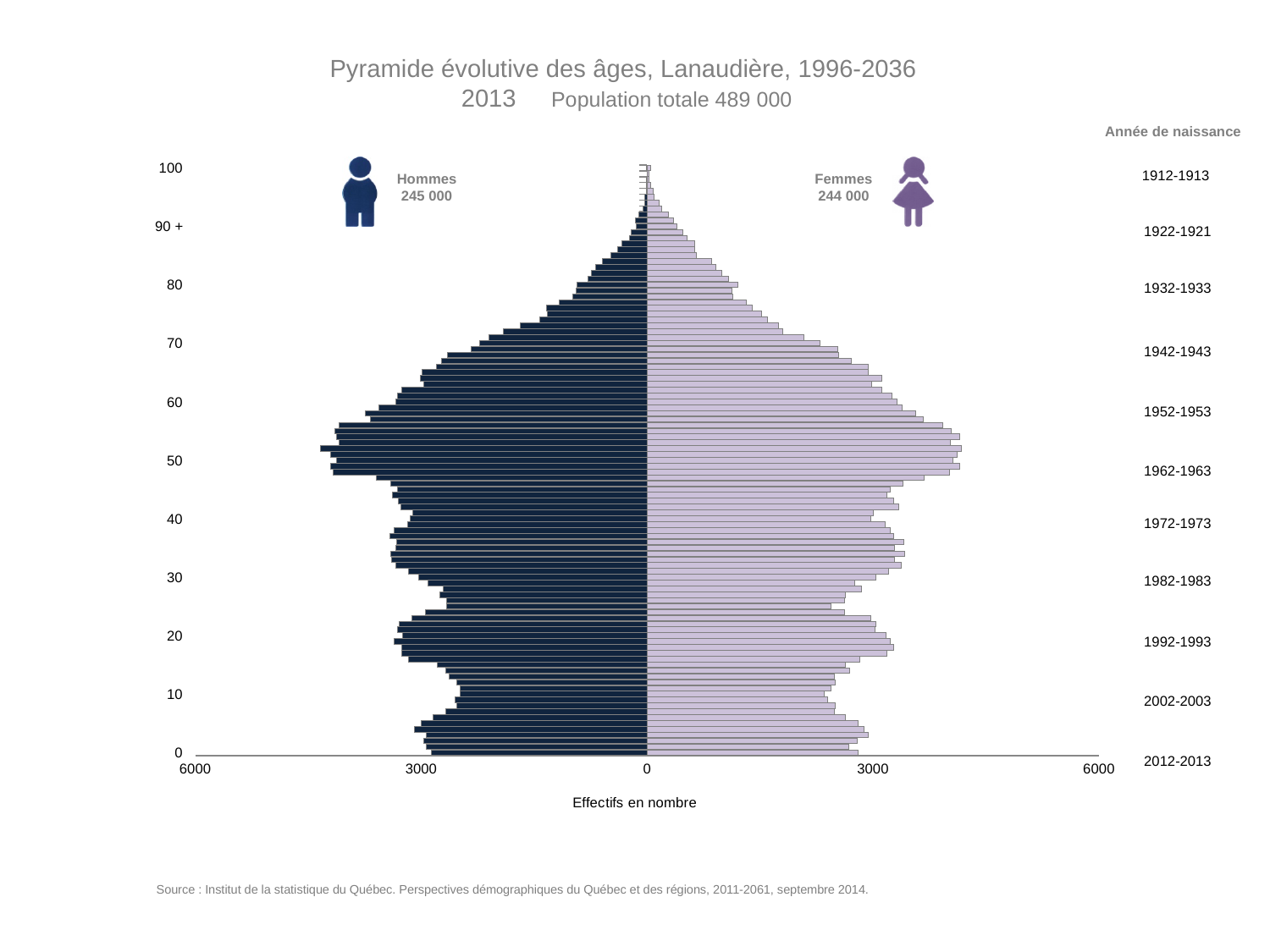
Which group is larger, Hommes or Femmes? Hommes What is the number of Hommes shown on the chart? 245 000 What is the label of the horizontal axis? Effectifs en nombre What kind of chart is shown on the slide? Bar chart (population pyramid) What is the title of the chart? Pyramide évolutive des âges, Lanaudière, 1996-2036 Is the number of Femmes aged 80 greater or less than 3000? less What is the difference between the number of Hommes and the number of Femmes? 1 000 Is the number of Hommes aged 10 greater or less than 3000? less Is the number of Hommes aged 50 greater or less than 3000? greater What is the number of Femmes shown on the chart? 244 000 What total population is shown for 2013? 489 000 What is the maximum value shown on the horizontal axis? 6000